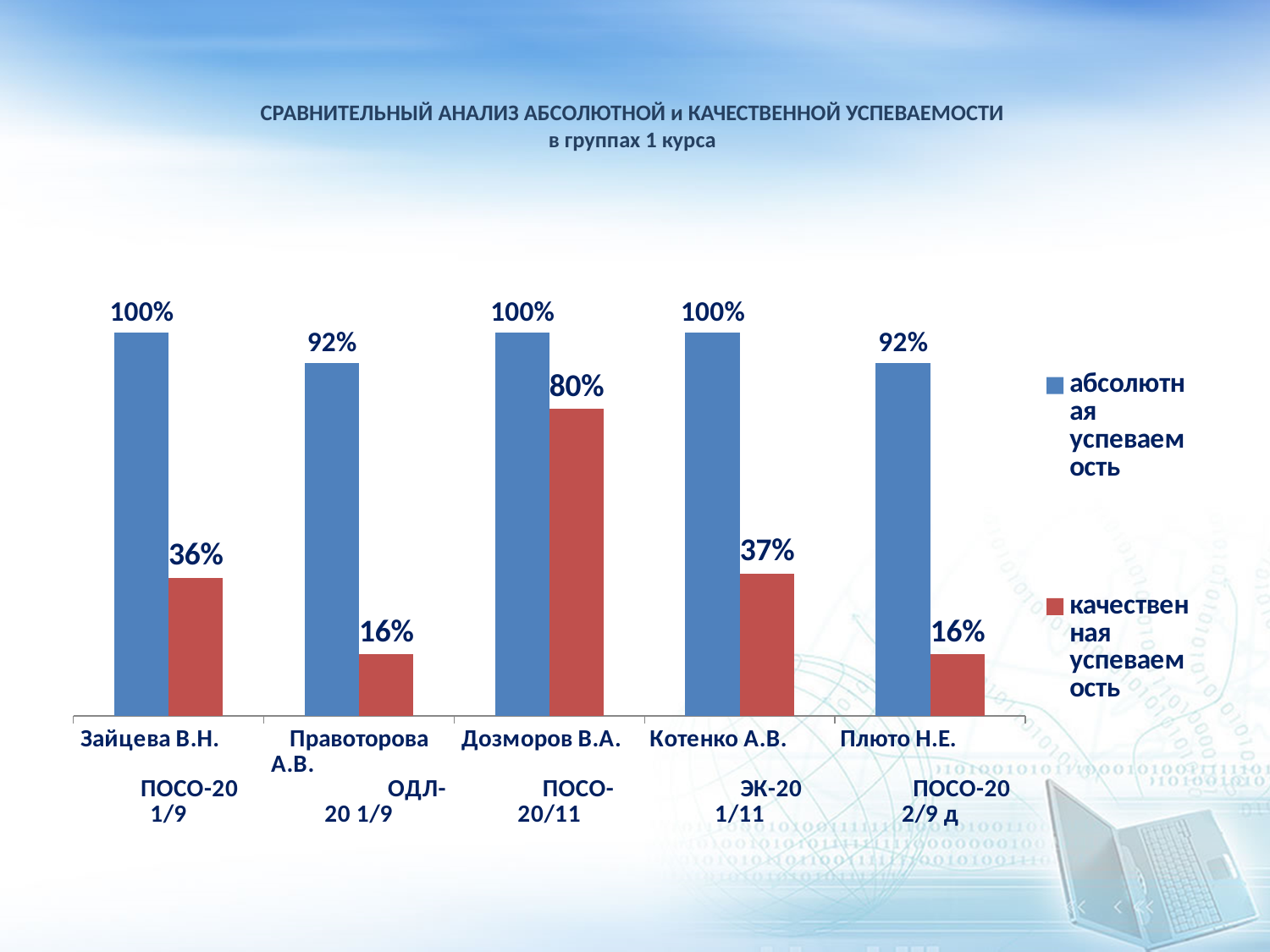
What is the difference between абсолютная and качественная успеваемость for Зайцева В.Н. (ПОСО-20 1/9)? 64% Which is larger: качественная успеваемость for Зайцева В.Н. or for Плюто Н.Е.? Зайцева В.Н. What is the difference in качественная успеваемость between Дозморов В.А. and Котенко А.В.? 43% What is the value of качественная успеваемость for Котенко А.В. (ЭК-20 1/11)? 37% What type of chart is shown on the slide? bar chart How many series does the legend list? 2 Which category has the highest качественная успеваемость? Дозморов В.А. What is the value of качественная успеваемость for Дозморов В.А. (ПОСО-20/11)? 80% What is the value of абсолютная успеваемость for Правоторова А.В. (ОДЛ-20 1/9)? 92% Which colour represents абсолютная успеваемость in the chart? blue What is the title of the chart? СРАВНИТЕЛЬНЫЙ АНАЛИЗ АБСОЛЮТНОЙ и КАЧЕСТВЕННОЙ УСПЕВАЕМОСТИ в группах 1 курса How many categories (teachers/groups) are shown on the x axis? 5